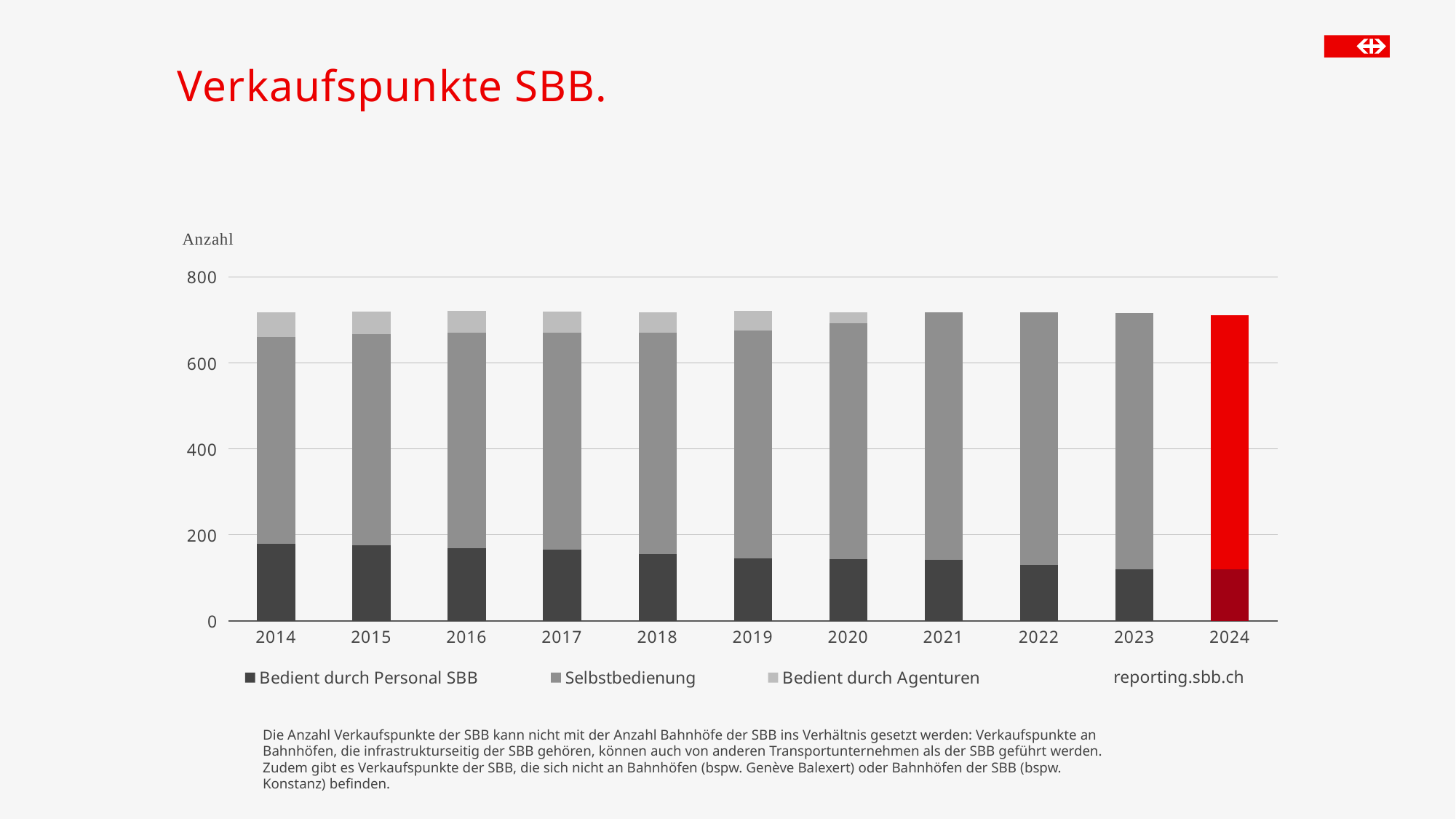
Is the value for Bedient durch Personal SBB in 2024 greater or less than 200? less How many years are shown on the x axis of the chart? 11 Is the total height of the stacked bar for 2019 greater or less than 800? less Does the Bedient durch Personal SBB series rise or fall from 2014 to 2024? fall What kind of chart is shown on the slide? stacked bar chart Is the Selbstbedienung segment in 2022 greater or less than 400? greater How many series does the chart legend list? 3 Is the Bedient durch Personal SBB value larger in 2014 or in 2024? 2014 Which three series are listed in the chart legend? Bedient durch Personal SBB, Selbstbedienung, Bedient durch Agenturen What is the title of the slide containing the chart? Verkaufspunkte SBB.